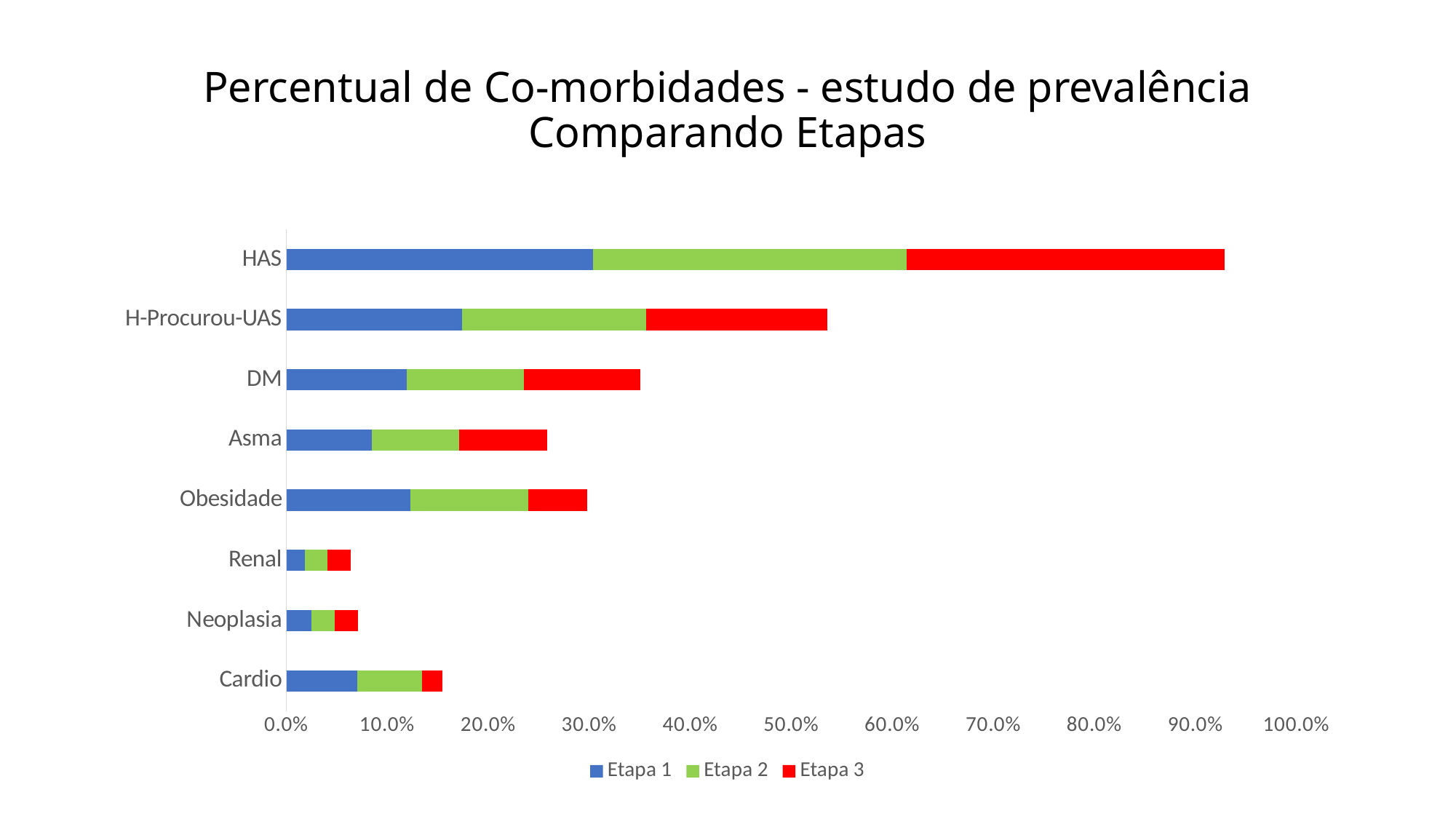
Which has the longer total bar, Obesidade or Asma? Obesidade Is the total bar for Cardio greater or less than 20.0%? less Is the total bar for DM greater or less than 40.0%? less What colour represents Etapa 3 in the chart? Red Which category has the longest total bar? HAS Is the total bar for H-Procurou-UAS greater or less than 50.0%? greater How many categories are plotted on the chart? 8 What kind of chart is shown on the slide? Stacked bar chart Which has the longer total bar, Cardio or Neoplasia? Cardio How many series does the legend list? 3